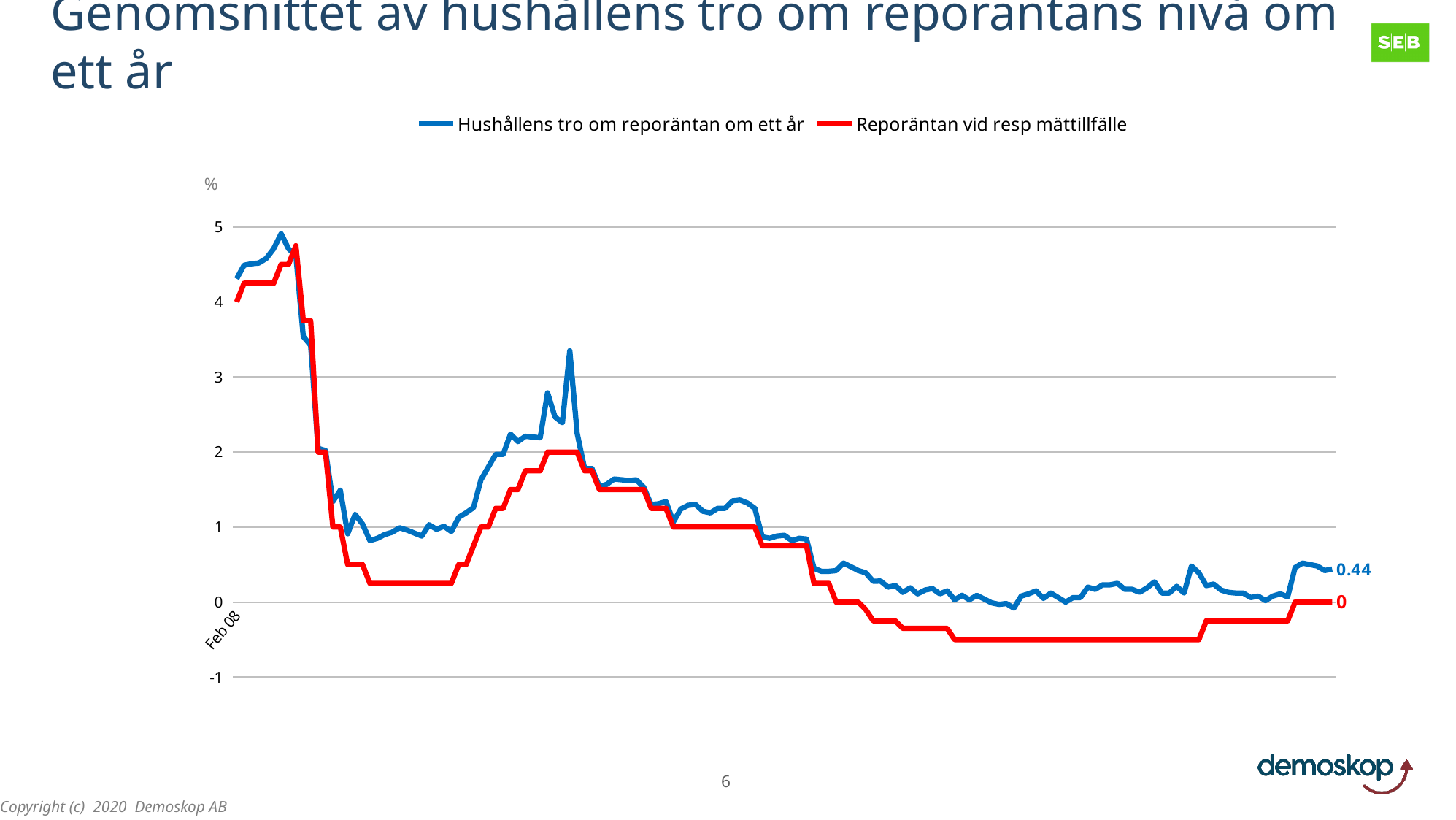
What kind of chart is shown on the slide? Line chart Which series reaches the lower minimum value on the chart? Reporäntan vid resp mättillfälle What colour is the line for 'Reporäntan vid resp mättillfälle'? Red At the right end of the chart, which series has the higher labelled value? Hushållens tro om reporäntan om ett år How many series does the legend list? 2 What unit is shown at the top of the y axis? % What is the difference between the final labelled values of the two series? 0.44 Overall, do the values of 'Hushållens tro om reporäntan om ett år' rise or fall from the start of the x axis to the end? Fall What is the final labelled value of the series 'Hushållens tro om reporäntan om ett år'? 0.44 Is the highest value of 'Hushållens tro om reporäntan om ett år' greater or less than 4? greater Is the lowest value of 'Reporäntan vid resp mättillfälle' greater or less than 0? less What is the final labelled value of the series 'Reporäntan vid resp mättillfälle'? 0